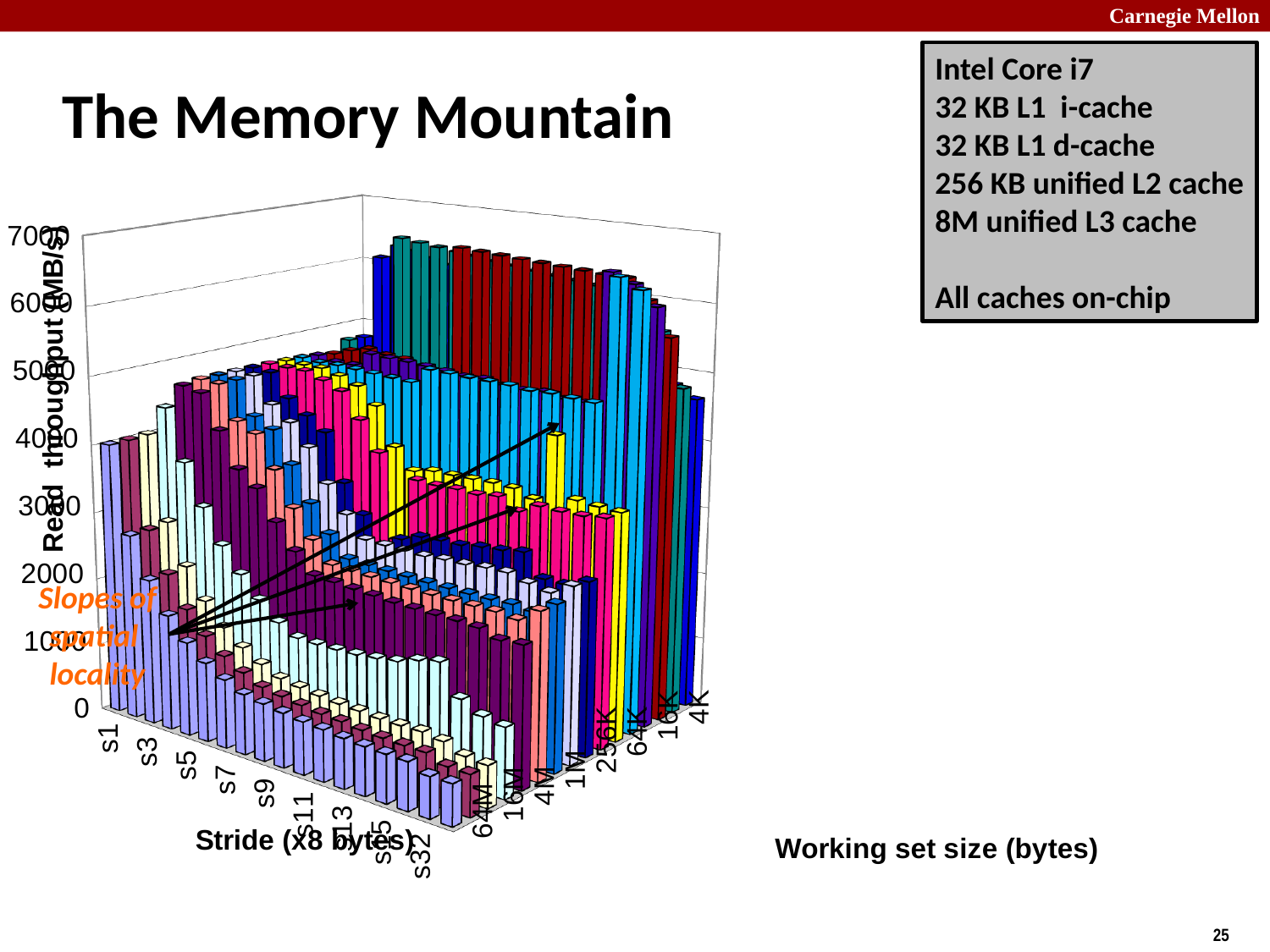
What is the interval between consecutive tick marks on the vertical axis? 1000 What is the label of the vertical axis of the chart? Read throughput (MB/s) How many working set size labels are printed along the working set size axis of the chart? 8 What is the smallest working set size labelled on the chart's working set size axis? 4K What kind of chart is shown on the slide? 3D bar chart What is the highest tick value shown on the vertical axis of the chart? 7000 What is the largest working set size labelled on the chart's working set size axis? 64M What is the lowest tick value shown on the vertical axis of the chart? 0 What is the first stride label shown on the stride axis of the chart? s1 How many stride labels are printed along the stride axis of the chart? 9 What is the title of the chart on the slide? The Memory Mountain What is the last stride label shown on the stride axis of the chart? s32